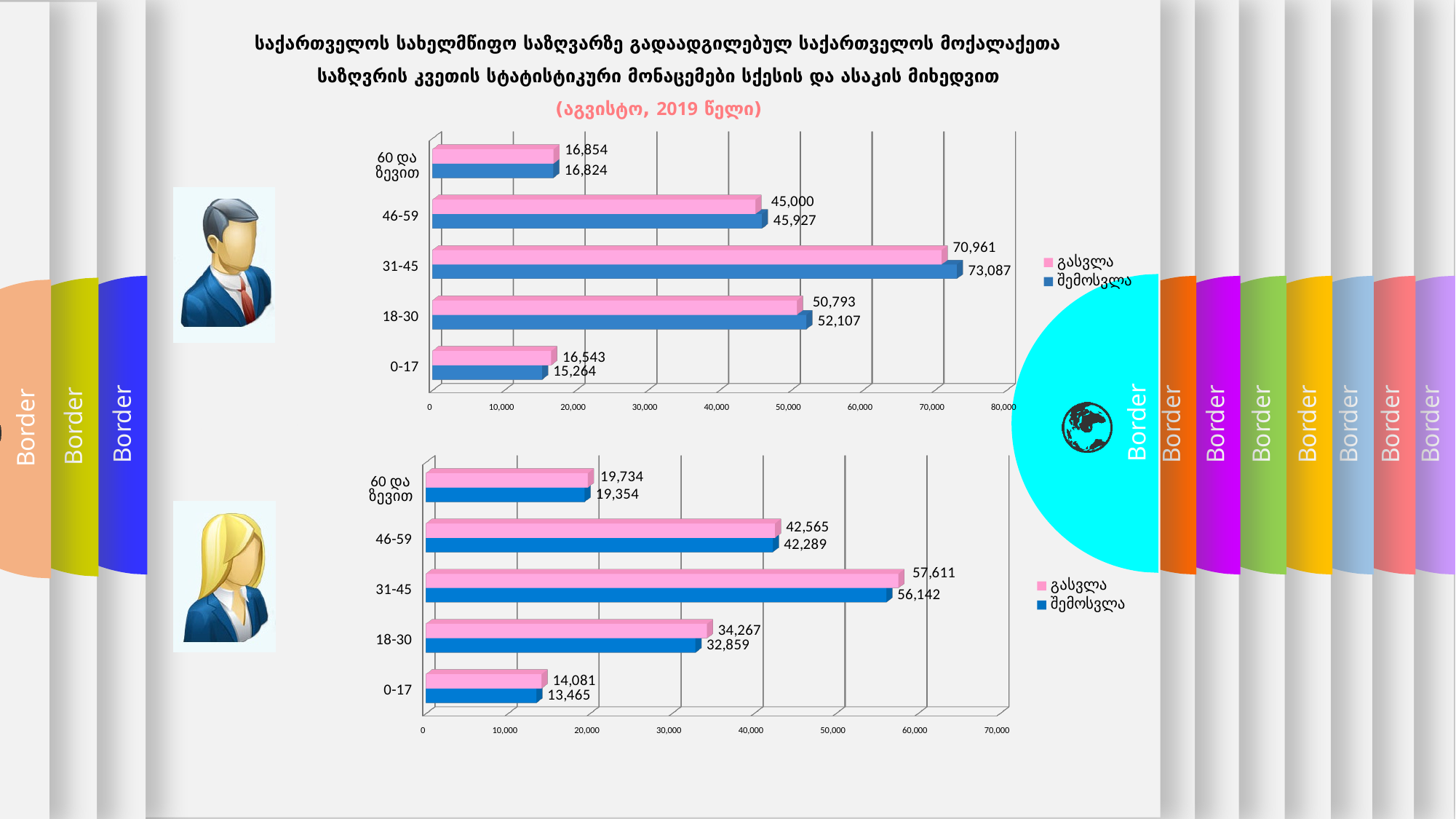
How many age groups are shown in the bottom chart? 5 In the bottom chart, what is the გასვლა value for the 46-59 age group? 42,565 In the bottom chart, what is the difference between the გასვლა and შემოსვლა values for the 60 და ზევით age group? 380 How many series does the legend of the top chart list? 2 In the top chart, which age group has the highest შემოსვლა value? 31-45 In the top chart, what is the გასვლა value for the 31-45 age group? 70,961 What type of chart is the top chart? Bar chart In the bottom chart, which age group has the lowest გასვლა value? 0-17 In the top chart, what is the difference between the შემოსვლა and გასვლა values for the 31-45 age group? 2,126 In the bottom chart, which is larger for the 18-30 age group, გასვლა or შემოსვლა? გასვლა In the bottom chart, what is the შემოსვლა value for the 0-17 age group? 13,465 In the top chart, what is the შემოსვლა value for the 18-30 age group? 52,107